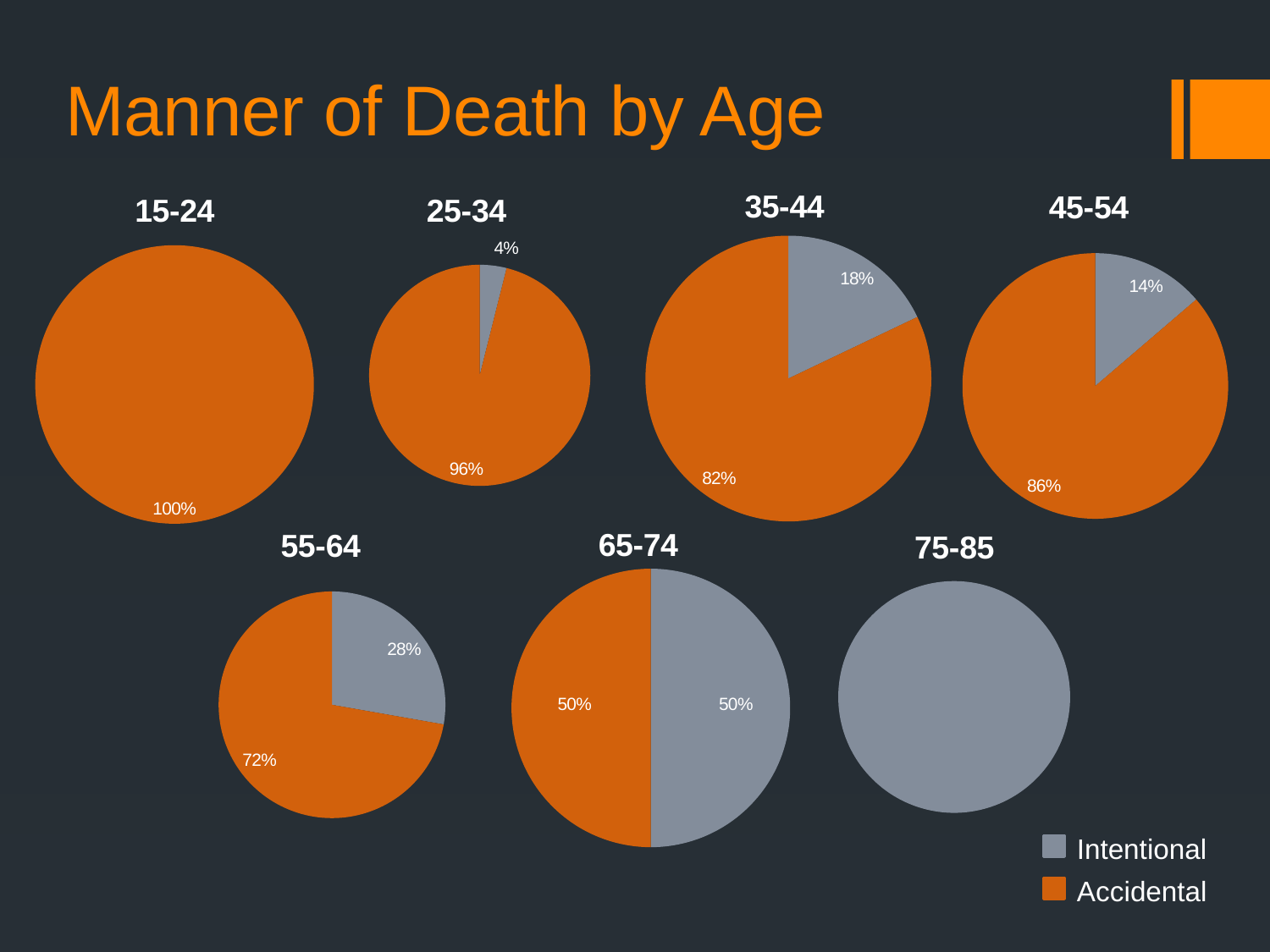
In the 15-24 pie chart, what percentage is shown for the Accidental slice? 100% How many series does the legend list? 2 How many pie charts are on the slide? 7 In the 45-54 pie chart, what percentage is shown for the Intentional slice? 14% In the 35-44 pie chart, what share of deaths is Accidental? 82% In the 55-64 pie chart, which slice is larger, Intentional or Accidental? Accidental Which series is shown in orange in the legend? Accidental What kind of charts are shown on the slide? Pie charts In the 65-74 pie chart, what share of deaths is Intentional? 50% In the 35-44 pie chart, what is the difference between the Accidental and Intentional shares? 64% In the 25-34 pie chart, what share of deaths is Intentional? 4% In the 55-64 pie chart, what percentage is shown for the Accidental slice? 72%